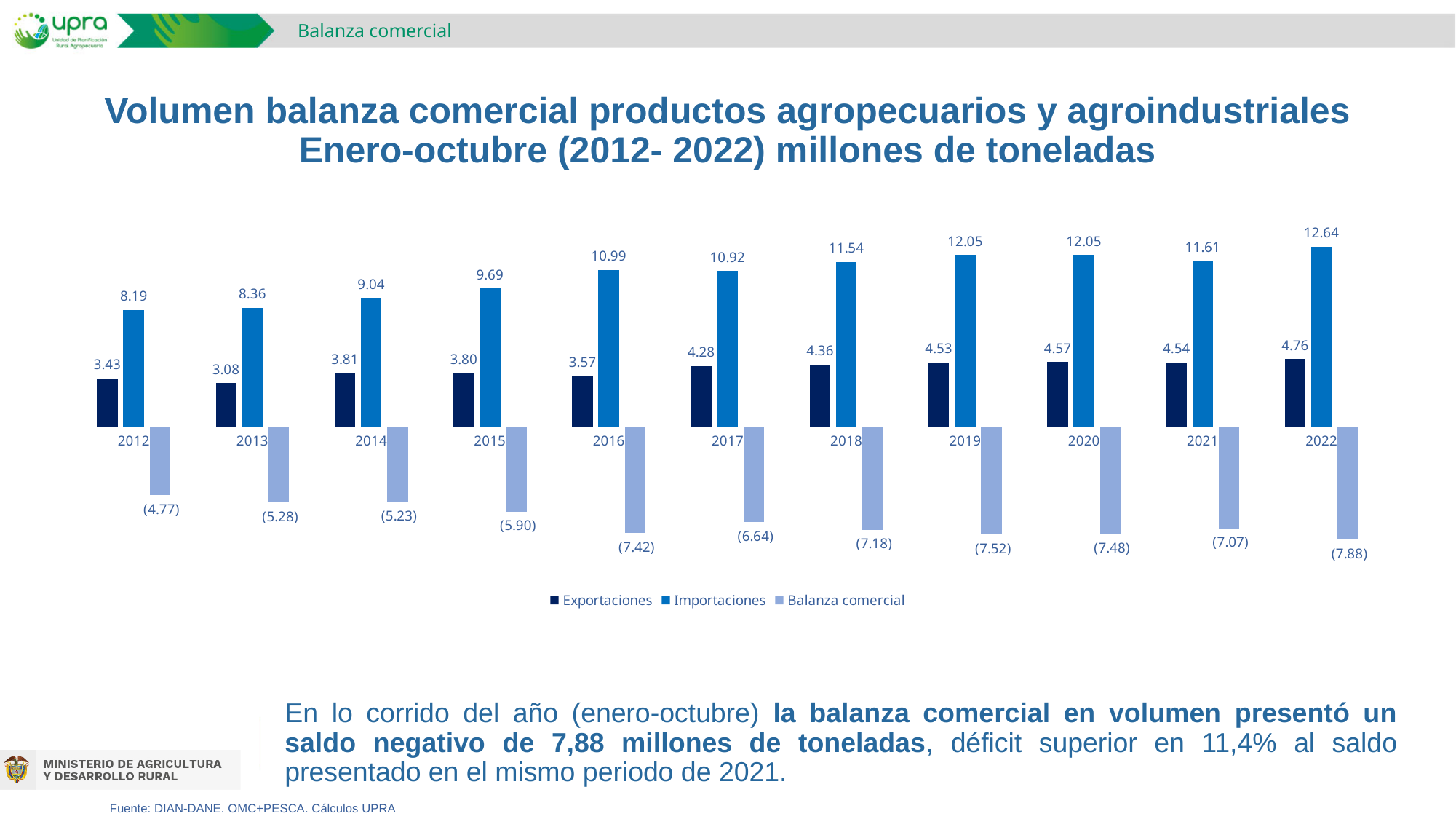
What is the difference between Importaciones and Exportaciones in 2022? 7.88 In which year is Exportaciones lowest? 2013 How many years are shown on the x axis? 11 What is the value of Exportaciones for 2013? 3.08 What kind of chart is shown on the slide? Bar chart In which year is Importaciones highest? 2022 Do the Importaciones values generally rise or fall from 2012 to 2022? Rise Which is larger, Importaciones in 2016 or Importaciones in 2017? 2016 What is the difference between Exportaciones in 2022 and Exportaciones in 2012? 1.33 How many series does the legend list? 3 What is the value of Balanza comercial for 2016? (7.42) What is the value of Importaciones for 2022? 12.64